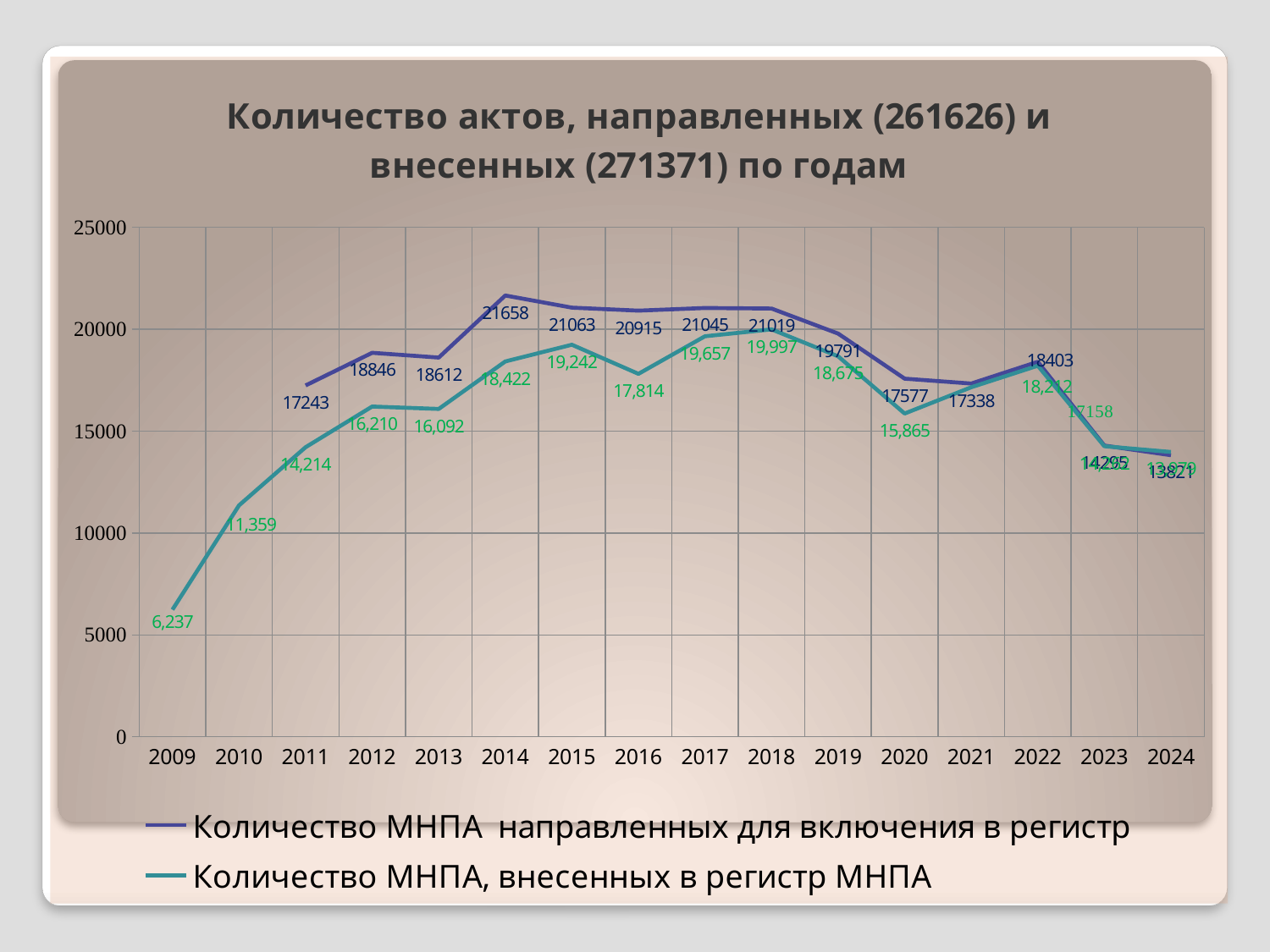
In which year does the series 'Количество МНПА направленных для включения в регистр' reach its highest value? 2014 Does the series 'Количество МНПА, внесенных в регистр МНПА' rise or fall from 2009 to 2014? rise In which year does the series 'Количество МНПА, внесенных в регистр МНПА' have its lowest value? 2009 What is the value for 2018 in the series 'Количество МНПА, внесенных в регистр МНПА'? 19,997 What is the value for 2009 in the series 'Количество МНПА, внесенных в регистр МНПА'? 6,237 Is the 2024 value for 'Количество МНПА направленных для включения в регистр' greater or less than 15000? less How many years are shown on the x axis? 16 What is the difference between the two series' values in 2014? 3236 What is the value for 2014 in the series 'Количество МНПА направленных для включения в регистр'? 21658 How many series does the legend list? 2 What kind of chart is shown on the slide? line chart In 2018, which series has the larger value? Количество МНПА направленных для включения в регистр